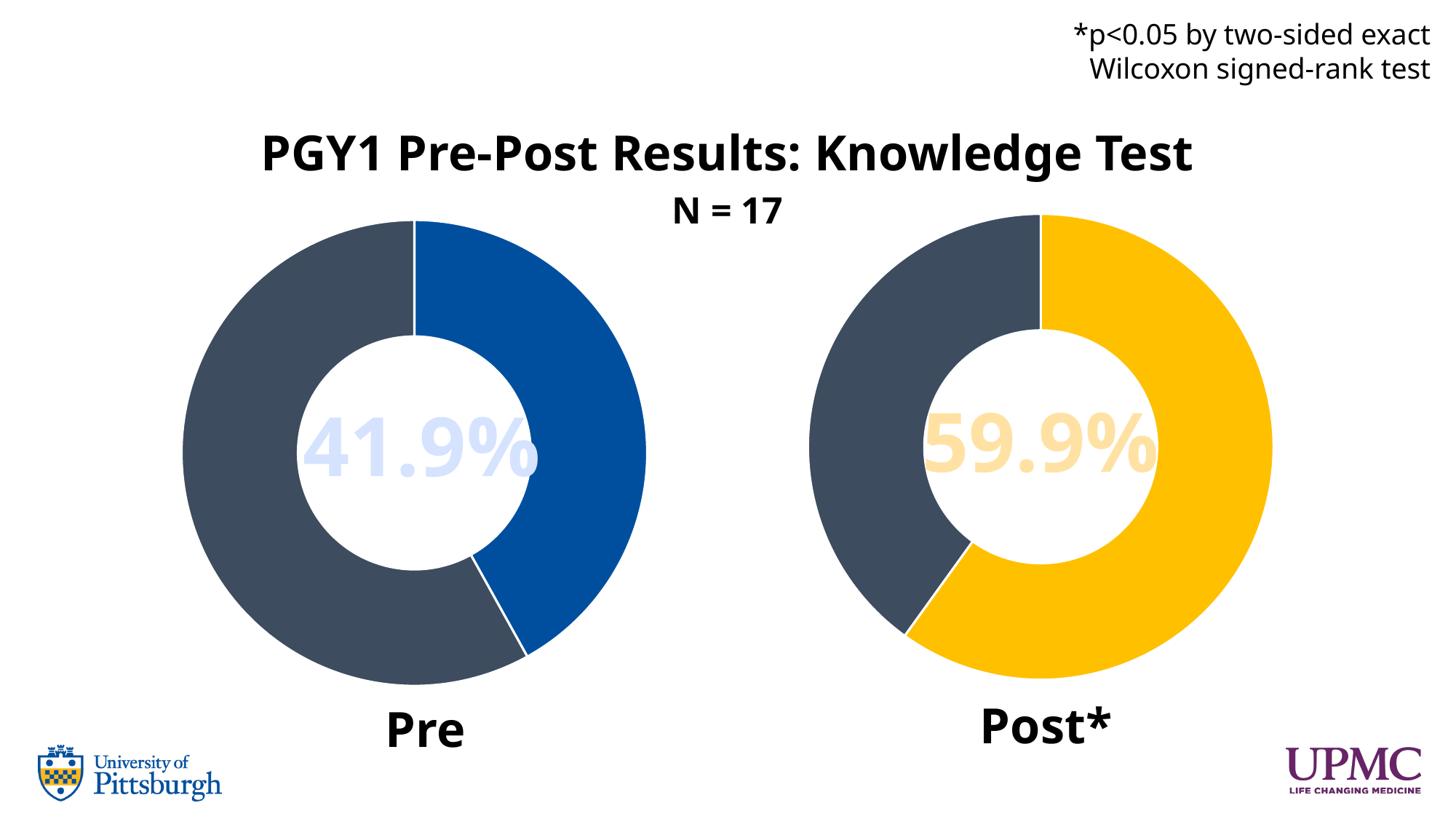
What sample size (N) is stated for the charts? N = 17 What is the title of the slide's chart? PGY1 Pre-Post Results: Knowledge Test Which chart shows the higher percentage, Pre or Post*? Post* Do the values rise or fall from the Pre chart to the Post* chart? rise Is the highlighted share in the Post* chart greater or less than 50%? greater In the Pre chart, what percentage is shown in the centre? 41.9% Which chart shows the lower percentage, Pre or Post*? Pre What is the difference in percentage points between the Post* value and the Pre value? 18.0 percentage points What kind of chart is used to show the Pre and Post results? Donut (pie) chart How many donut charts are shown on the slide? 2 Is the highlighted share in the Pre chart greater or less than 50%? less In the Post* chart, what percentage is shown in the centre? 59.9%